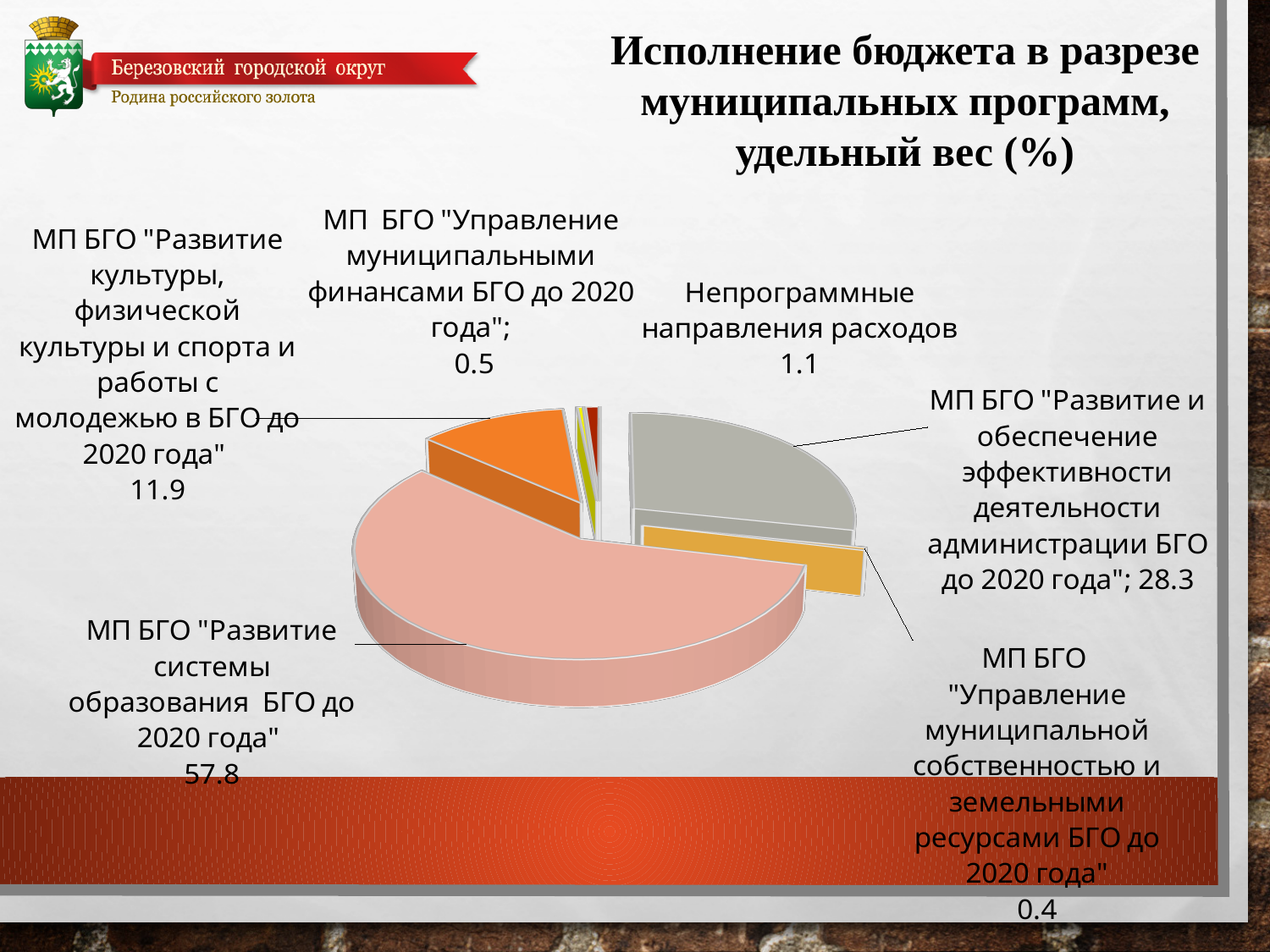
What is the difference between the values for Непрограммные направления расходов and МП БГО "Управление муниципальной собственностью и земельными ресурсами БГО до 2020 года"? 0.7 Which category has the largest share of the pie? МП БГО "Развитие системы образования БГО до 2020 года" What is the value for МП БГО "Развитие и обеспечение эффективности деятельности администрации БГО до 2020 года"? 28.3 Which is larger: the value for МП БГО "Развитие культуры, физической культуры и спорта и работы с молодежью в БГО до 2020 года" or the value for Непрограммные направления расходов? МП БГО "Развитие культуры, физической культуры и спорта и работы с молодежью в БГО до 2020 года" Which category has the smallest share of the pie? МП БГО "Управление муниципальной собственностью и земельными ресурсами БГО до 2020 года" What is the value for МП БГО "Управление муниципальными финансами БГО до 2020 года"? 0.5 What is the title of the chart? Исполнение бюджета в разрезе муниципальных программ, удельный вес (%) What is the value for Непрограммные направления расходов? 1.1 How many slices does the pie chart have? 6 What kind of chart is shown on the slide? pie chart What is the value for МП БГО "Развитие системы образования БГО до 2020 года"? 57.8 What is the difference between the values for МП БГО "Развитие системы образования БГО до 2020 года" and МП БГО "Развитие и обеспечение эффективности деятельности администрации БГО до 2020 года"? 29.5